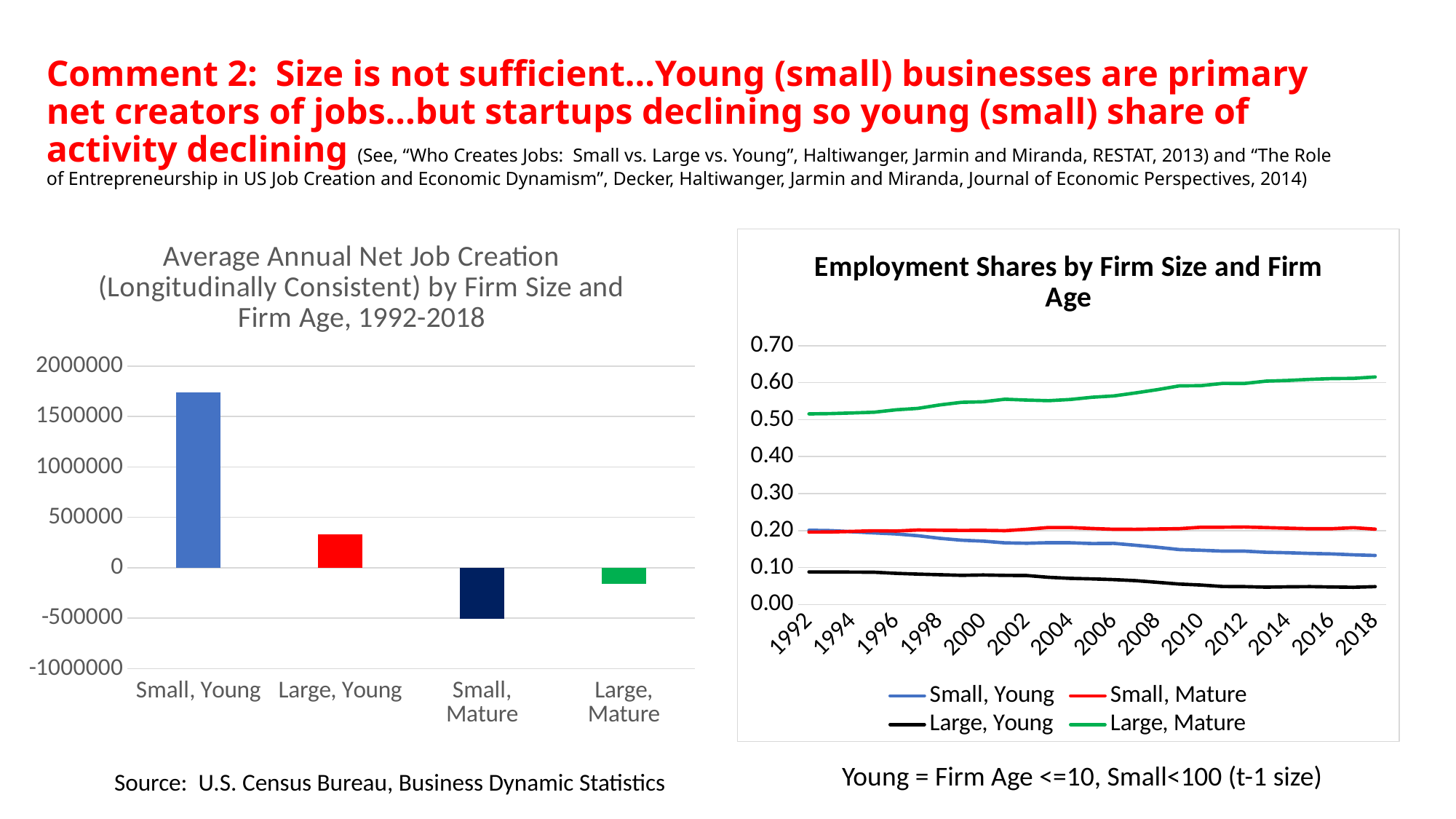
In the 'Average Annual Net Job Creation' chart, which category has the highest value? Small, Young In the 'Employment Shares by Firm Size and Firm Age' chart, does the Small, Young series rise or fall from 1992 to 2018? fall In the 'Employment Shares by Firm Size and Firm Age' chart, how many series does the legend list? 4 What kind of chart is the 'Employment Shares by Firm Size and Firm Age' chart on the right? line chart In the 'Employment Shares by Firm Size and Firm Age' chart, which series is shown in green? Large, Mature What kind of chart is the 'Average Annual Net Job Creation' chart on the left? bar chart In the 'Average Annual Net Job Creation' chart, is the value for Small, Young greater or less than 1500000? greater In the 'Employment Shares by Firm Size and Firm Age' chart, does the Large, Mature series rise or fall from 1992 to 2018? rise In the 'Average Annual Net Job Creation' chart, is the value for Large, Young greater or less than 500000? less In the 'Average Annual Net Job Creation' chart, how many categories are shown on the x axis? 4 In the 'Average Annual Net Job Creation' chart, which category has the lowest value? Small, Mature In the 'Average Annual Net Job Creation' chart, which is larger, the value for Large, Young or the value for Large, Mature? Large, Young